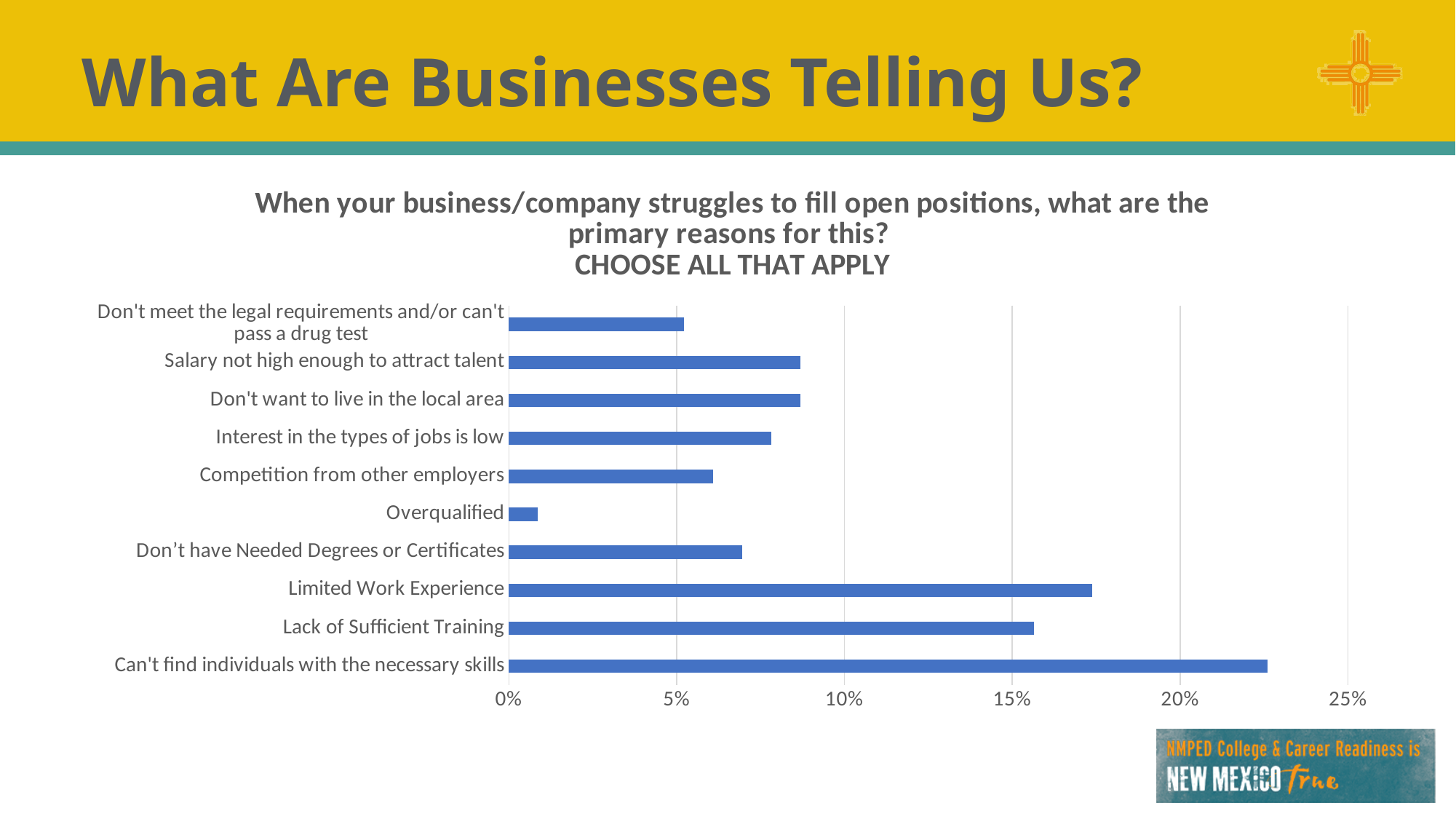
Is the value for "Overqualified" greater or less than 5%? less Which reason has the highest value in the chart? Can't find individuals with the necessary skills Is the value for "Salary not high enough to attract talent" greater or less than 10%? less Which reason has the lowest value in the chart? Overqualified Which is larger: the value for "Interest in the types of jobs is low" or the value for "Overqualified"? Interest in the types of jobs is low Is the value for "Can't find individuals with the necessary skills" greater or less than 20%? greater Which is larger: the value for "Limited Work Experience" or the value for "Lack of Sufficient Training"? Limited Work Experience What kind of chart is shown on the slide? bar chart What is the highest percentage tick shown on the horizontal axis of the chart? 25% How many categories (reasons) are plotted in the chart? 10